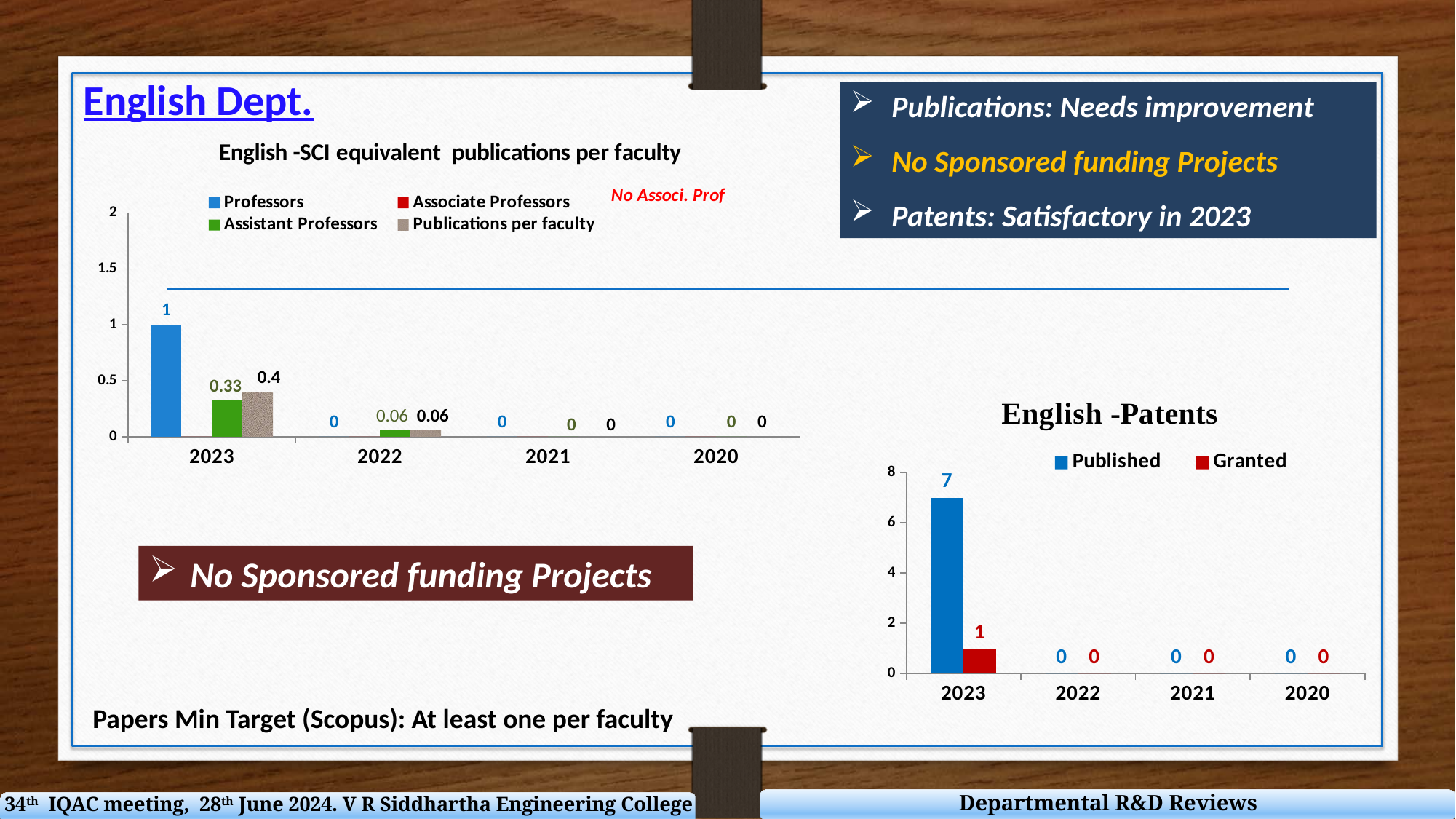
In the 'English -Patents' chart, what is the difference between Published and Granted patents in 2023? 6 In the 'English -SCI equivalent publications per faculty' chart, which year has the highest Publications per faculty value? 2023 In the 'English -SCI equivalent publications per faculty' chart, how many series does the legend list? 4 In the 'English -Patents' chart, which is larger in 2023, Published or Granted? Published In the 'English -SCI equivalent publications per faculty' chart, how many years are shown on the x axis? 4 In the 'English -Patents' chart, how many patents were Granted in 2023? 1 In the 'English -Patents' chart, how many patents were Published in 2023? 7 In the 'English -SCI equivalent publications per faculty' chart, what is the difference between the Publications per faculty values for 2023 and 2022? 0.34 What type of chart is the 'English -Patents' chart? Bar chart In the 'English -SCI equivalent publications per faculty' chart, what is the value for Assistant Professors in 2023? 0.33 In the 'English -SCI equivalent publications per faculty' chart, what is the value for Professors in 2023? 1 In the 'English -SCI equivalent publications per faculty' chart, what is the Publications per faculty value for 2022? 0.06